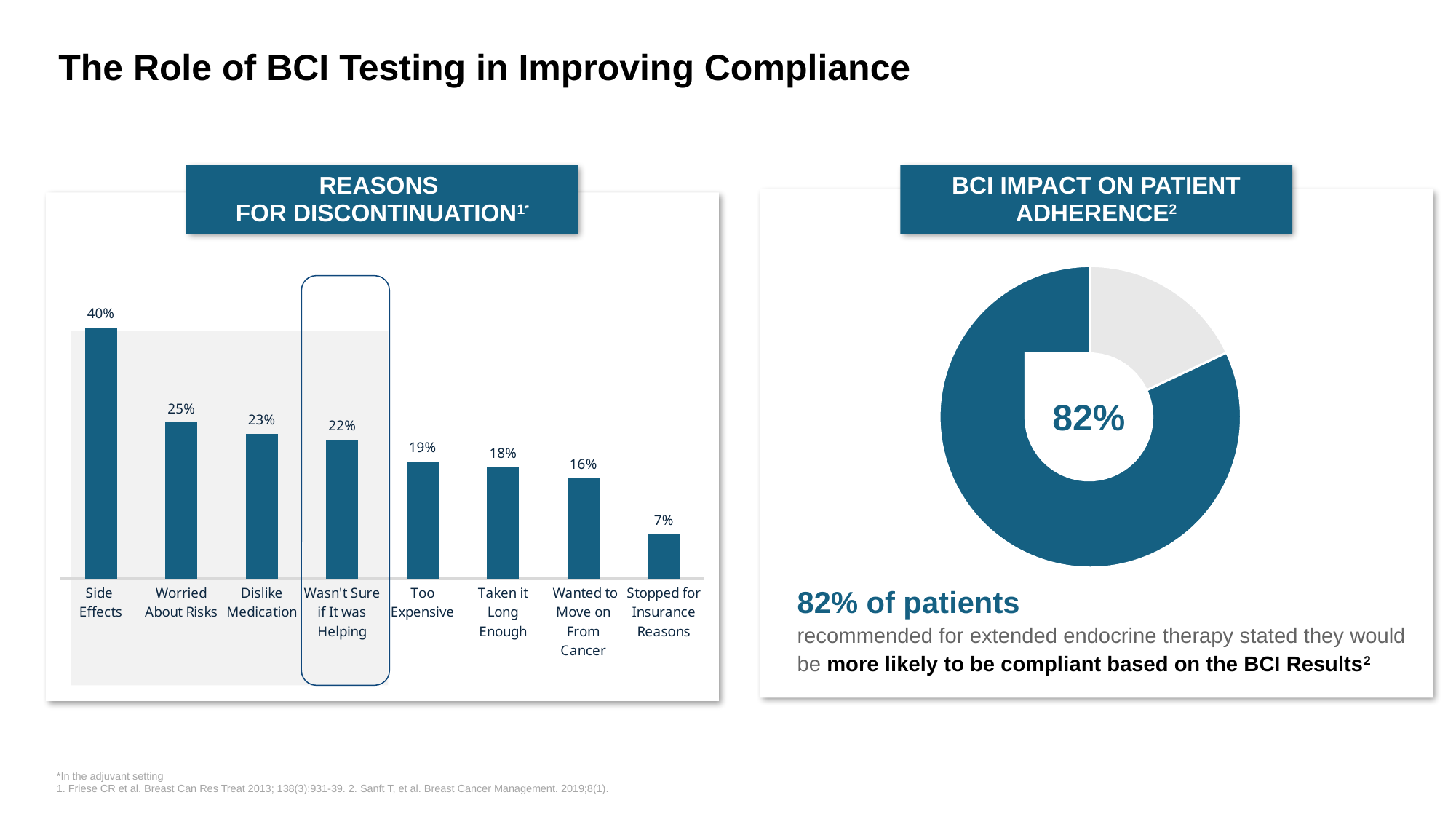
In the 'Reasons for Discontinuation' chart, what is the value for Wasn't Sure if It was Helping? 22% What kind of chart is the 'Reasons for Discontinuation' chart? Bar chart How many categories are shown in the 'Reasons for Discontinuation' chart? 8 In the 'Reasons for Discontinuation' chart, which category has the highest value? Side Effects In the 'Reasons for Discontinuation' chart, do the values rise or fall from left to right? Fall In the 'Reasons for Discontinuation' chart, what is the difference between Side Effects and Worried About Risks? 15% In the 'Reasons for Discontinuation' chart, which category has the lowest value? Stopped for Insurance Reasons In the 'Reasons for Discontinuation' chart, which is larger: Too Expensive or Wanted to Move on From Cancer? Too Expensive What kind of chart is the 'BCI Impact on Patient Adherence' chart? Doughnut chart In the 'BCI Impact on Patient Adherence' chart, what share of patients is shown by the dark blue segment? 82% In the 'Reasons for Discontinuation' chart, what is the value for Side Effects? 40% In the 'Reasons for Discontinuation' chart, what is the value for Stopped for Insurance Reasons? 7%